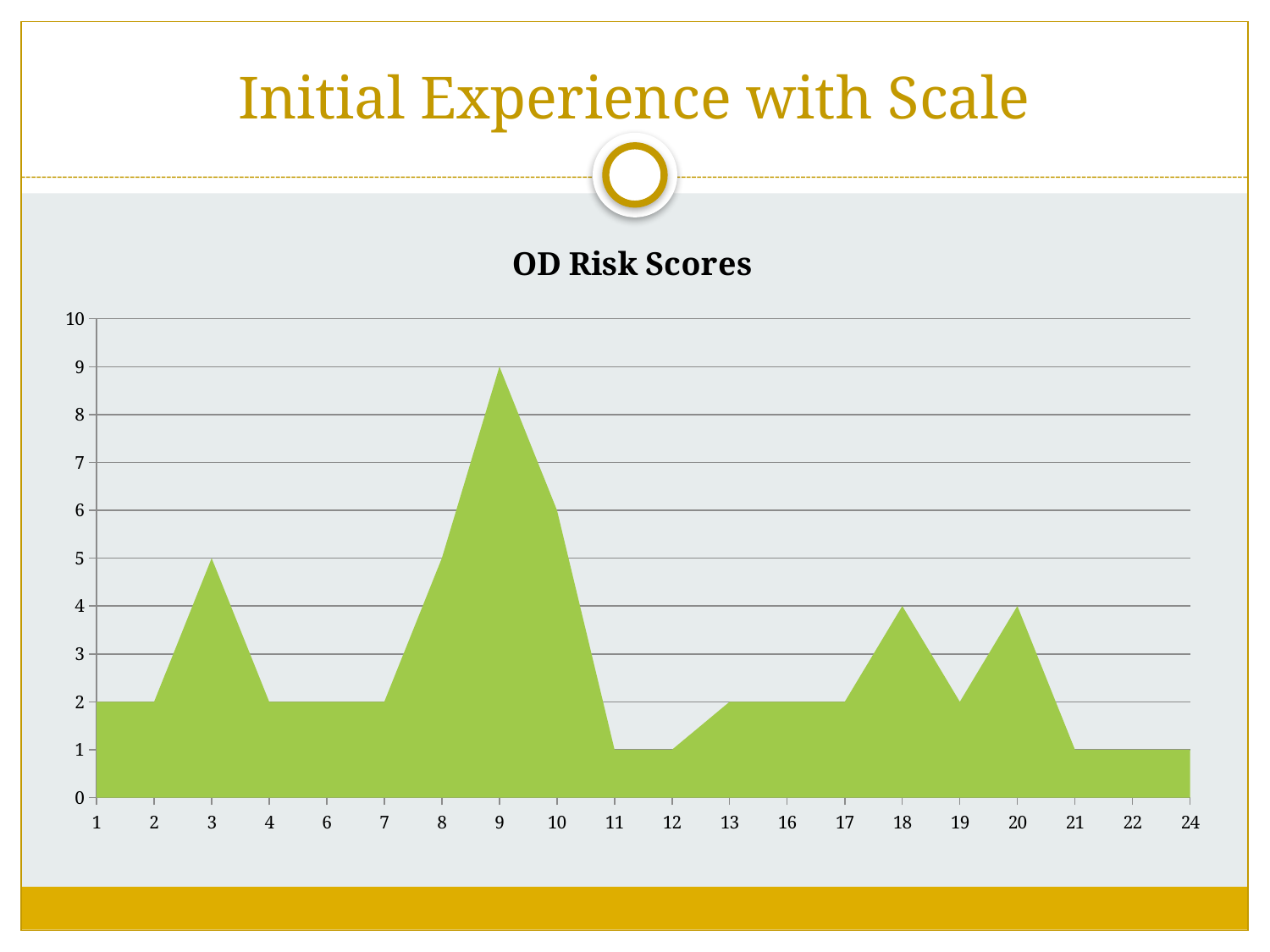
What is the OD risk score for category 9? 9 Which category has the highest OD risk score? 9 What is the OD risk score for category 3? 5 What is the difference between the OD risk scores for category 9 and category 3? 4 What is the title of the chart? OD Risk Scores How many categories are shown on the x axis? 20 Which has a higher OD risk score, category 3 or category 20? category 3 What is the OD risk score for category 11? 1 What kind of chart is shown on the slide? area chart Do the OD risk scores rise or fall from category 9 to category 11? fall What is the OD risk score for category 18? 4 Is the value for category 10 greater or less than 5? greater